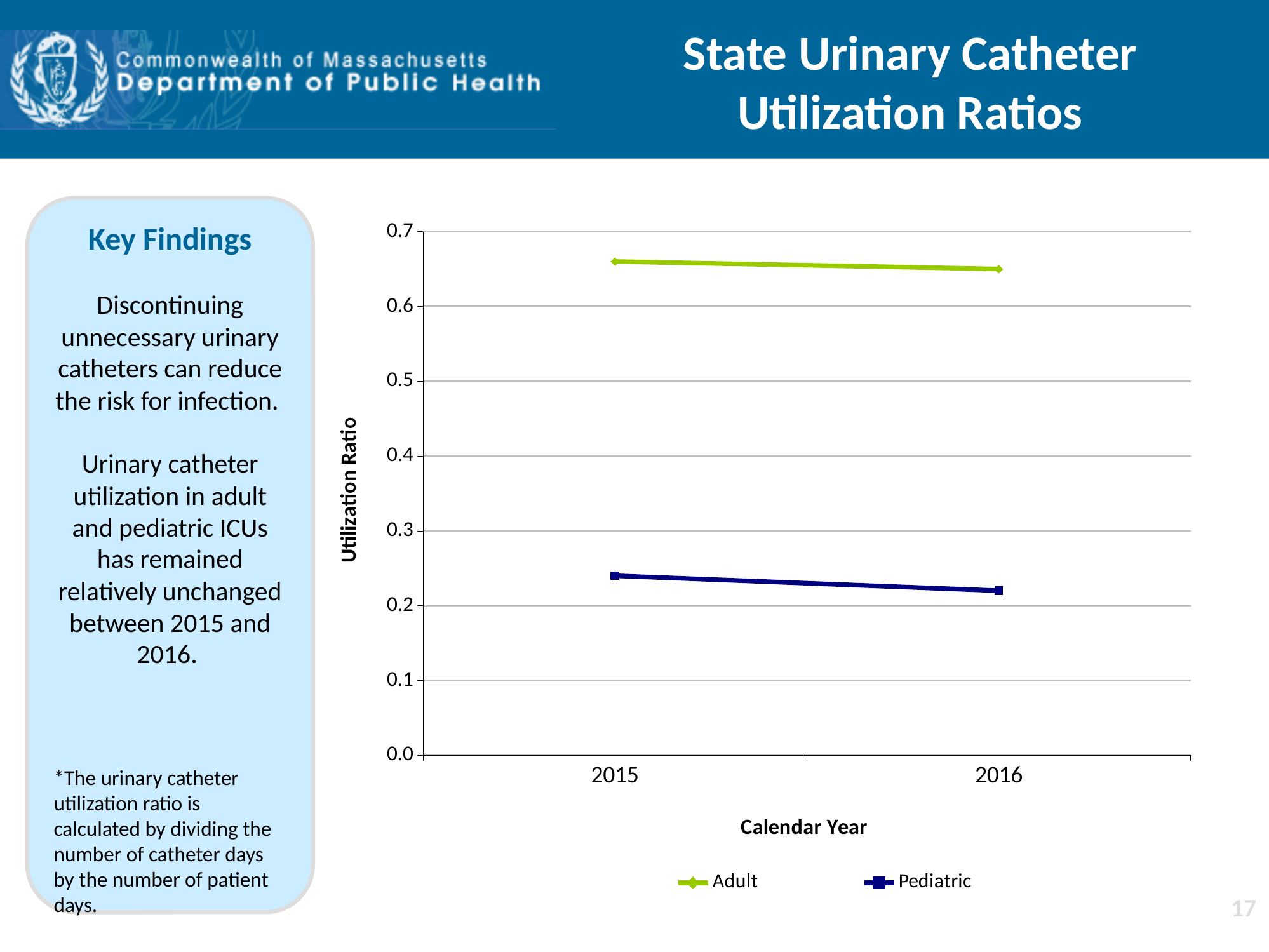
Which series has the higher utilization ratio in 2016, Adult or Pediatric? Adult Which series are listed in the legend? Adult and Pediatric Does the Adult utilization ratio rise or fall from 2015 to 2016? fall Is the Pediatric utilization ratio in 2015 greater or less than 0.2? greater Which series has the lower utilization ratio in 2015? Pediatric How many calendar years are plotted on the x axis? 2 What kind of chart is shown on the slide? line chart Is the Adult utilization ratio in 2015 greater or less than 0.6? greater How many series does the legend list? 2 Is the Pediatric utilization ratio in 2016 greater or less than 0.3? less What is the label of the y axis? Utilization Ratio